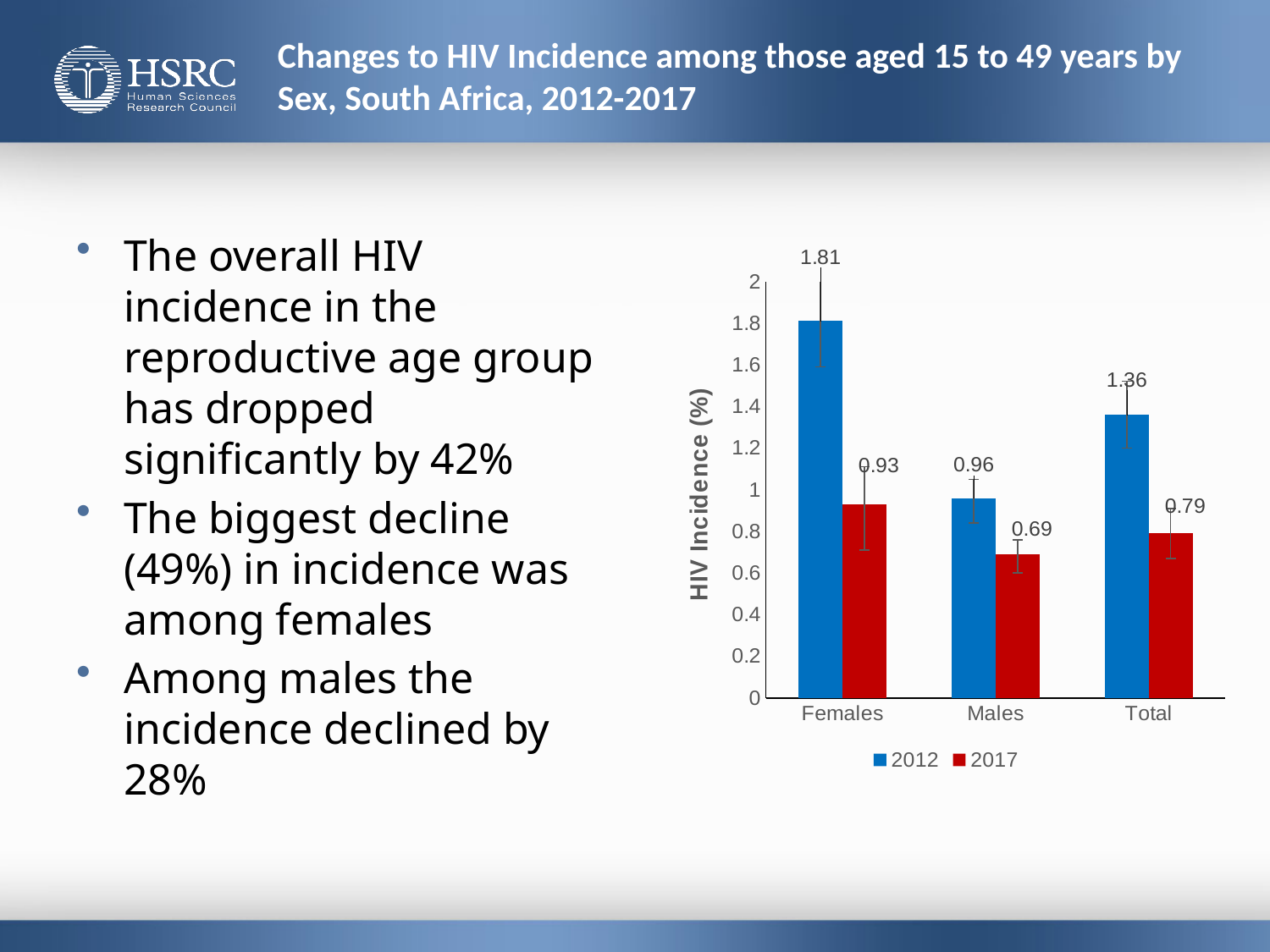
Which is larger: the 2017 value for Females or the 2012 value for Males? 2012 value for Males How many series does the legend list? 2 What is the HIV incidence for Total in 2012? 1.36 What is the HIV incidence for Males in 2017? 0.69 What kind of chart is shown on the slide? Bar chart Which category has the lowest HIV incidence in 2017? Males How many categories are shown on the x axis? 3 What is the difference between the 2012 and 2017 HIV incidence for Females? 0.88 Which category has the highest HIV incidence in 2012? Females What is the label of the y axis? HIV Incidence (%) What is the HIV incidence for Females in 2012? 1.81 Is the 2012 HIV incidence for Total greater or less than 1.2? greater